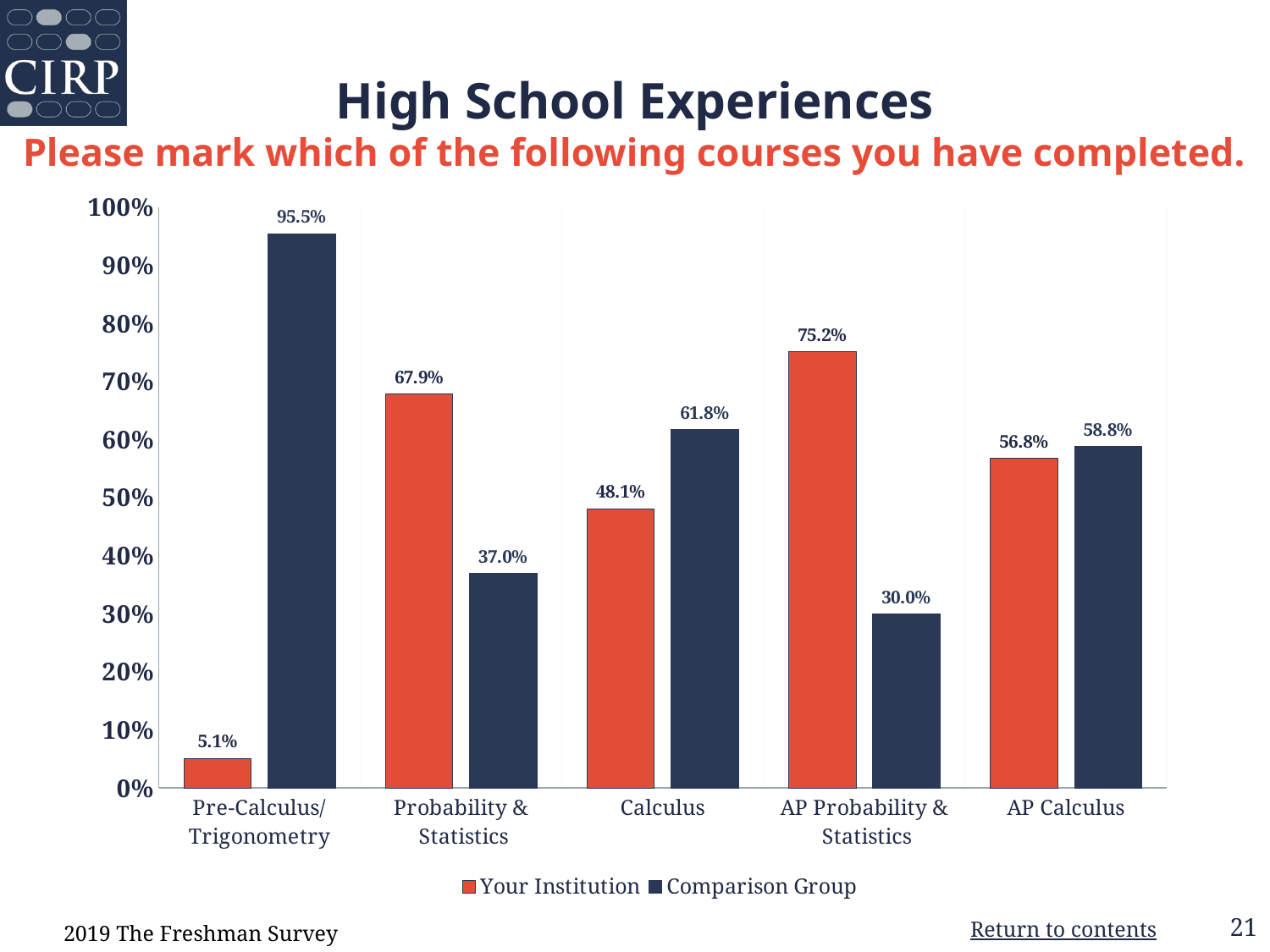
Is the value for Comparison Group for AP Calculus greater or less than 50%? greater What is the value for Your Institution for AP Probability & Statistics? 75.2% What is the value for Comparison Group for Pre-Calculus/Trigonometry? 95.5% What is the difference between Comparison Group and Your Institution for Pre-Calculus/Trigonometry? 90.4% What is the difference between Your Institution and Comparison Group for Probability & Statistics? 30.9% What kind of chart is shown on the slide? Bar chart How many courses are shown on the x axis? 5 Which course has the lowest value for Comparison Group? AP Probability & Statistics Which is larger for Calculus: Your Institution or Comparison Group? Comparison Group How many series does the legend list? 2 What is the value for Your Institution for Calculus? 48.1% Which course has the highest value for Your Institution? AP Probability & Statistics